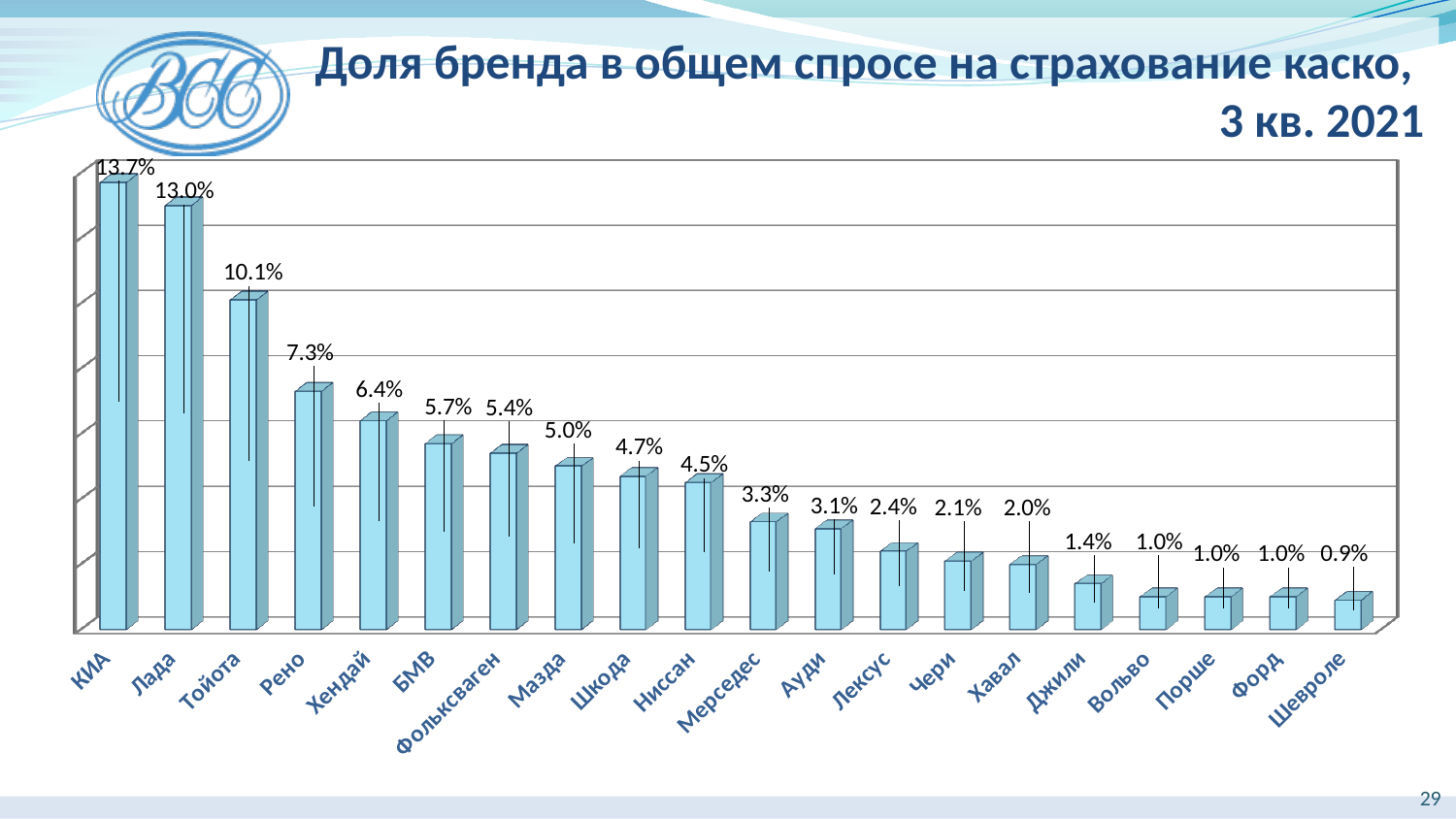
What is the value for Тойота? 10.1% Which is larger, the value for Мазда or the value for Ниссан? Мазда What is the value for Фольксваген? 5.4% What is the difference between the values for КИА and Лада? 0.7% What kind of chart is shown on the slide? Bar chart What is the value for Хавал? 2.0% What is the difference between the values for Рено and Хендай? 0.9% Which brand has the highest share? КИА Do the values rise or fall from left to right along the x axis? Fall What is the value for КИА? 13.7% How many brands are shown on the chart? 20 Which brand has the lowest share? Шевроле